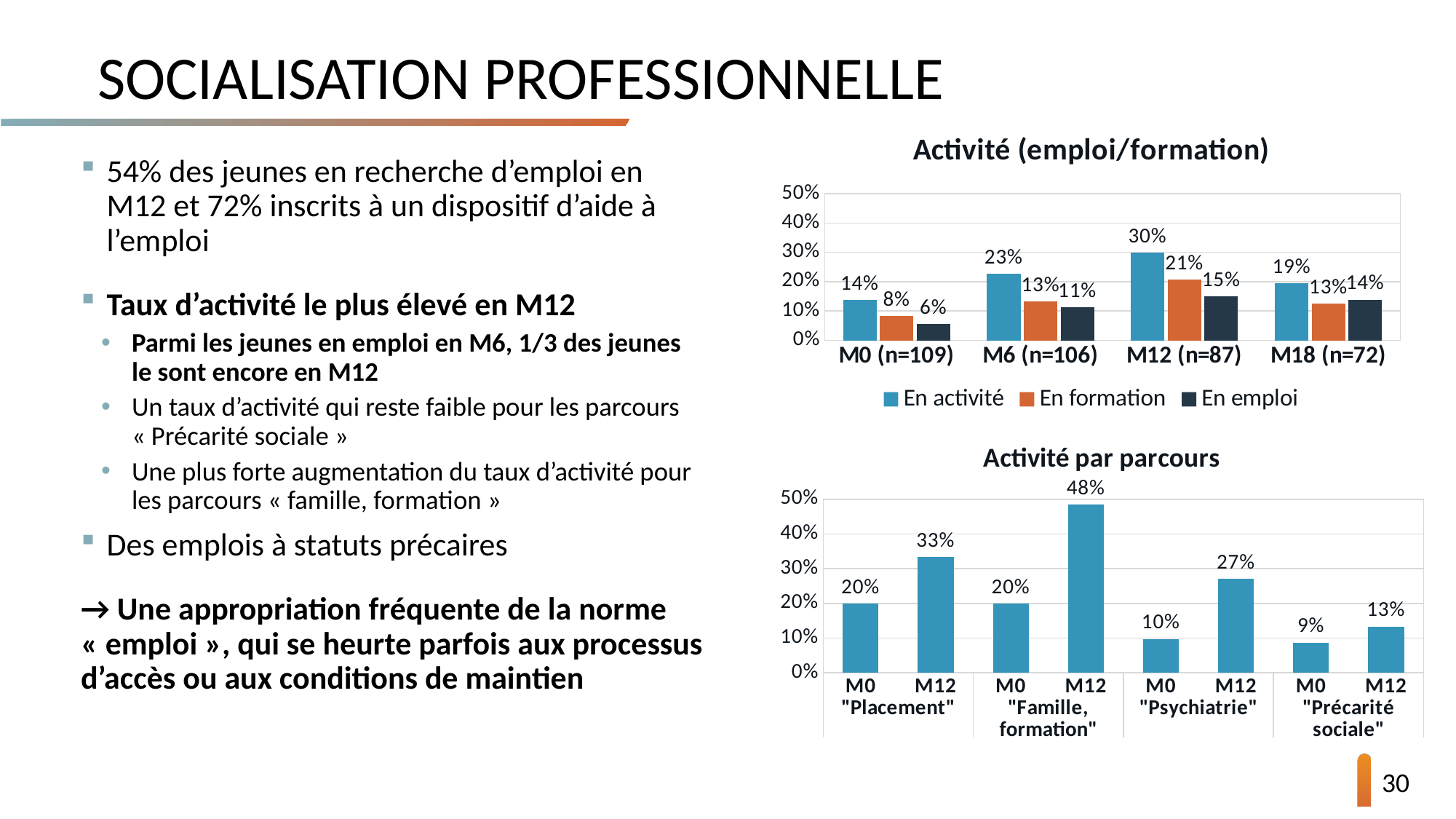
In the 'Activité par parcours' chart, what is the value for M12 in the 'Famille, formation' group? 48% What type of chart is 'Activité par parcours'? Bar chart In the 'Activité par parcours' chart, is the value for M12 'Placement' greater or less than 30%? greater In the 'Activité (emploi/formation)' chart, what is the difference between 'En activité' and 'En formation' at M6 (n=106)? 10% In the 'Activité (emploi/formation)' chart, how many series does the legend list? 3 In the 'Activité (emploi/formation)' chart, what is the value for 'En activité' at M12 (n=87)? 30% In the 'Activité par parcours' chart, what is the difference between M12 and M0 for 'Psychiatrie'? 17% In the 'Activité (emploi/formation)' chart, which is larger at M18 (n=72): 'En formation' or 'En activité'? En activité In the 'Activité par parcours' chart, how many bars are plotted? 8 In the 'Activité (emploi/formation)' chart, what is the value for 'En emploi' at M0 (n=109)? 6% In the 'Activité (emploi/formation)' chart, which time point has the highest 'En activité' value? M12 (n=87) In the 'Activité par parcours' chart, which bar has the lowest value? M0 "Précarité sociale"